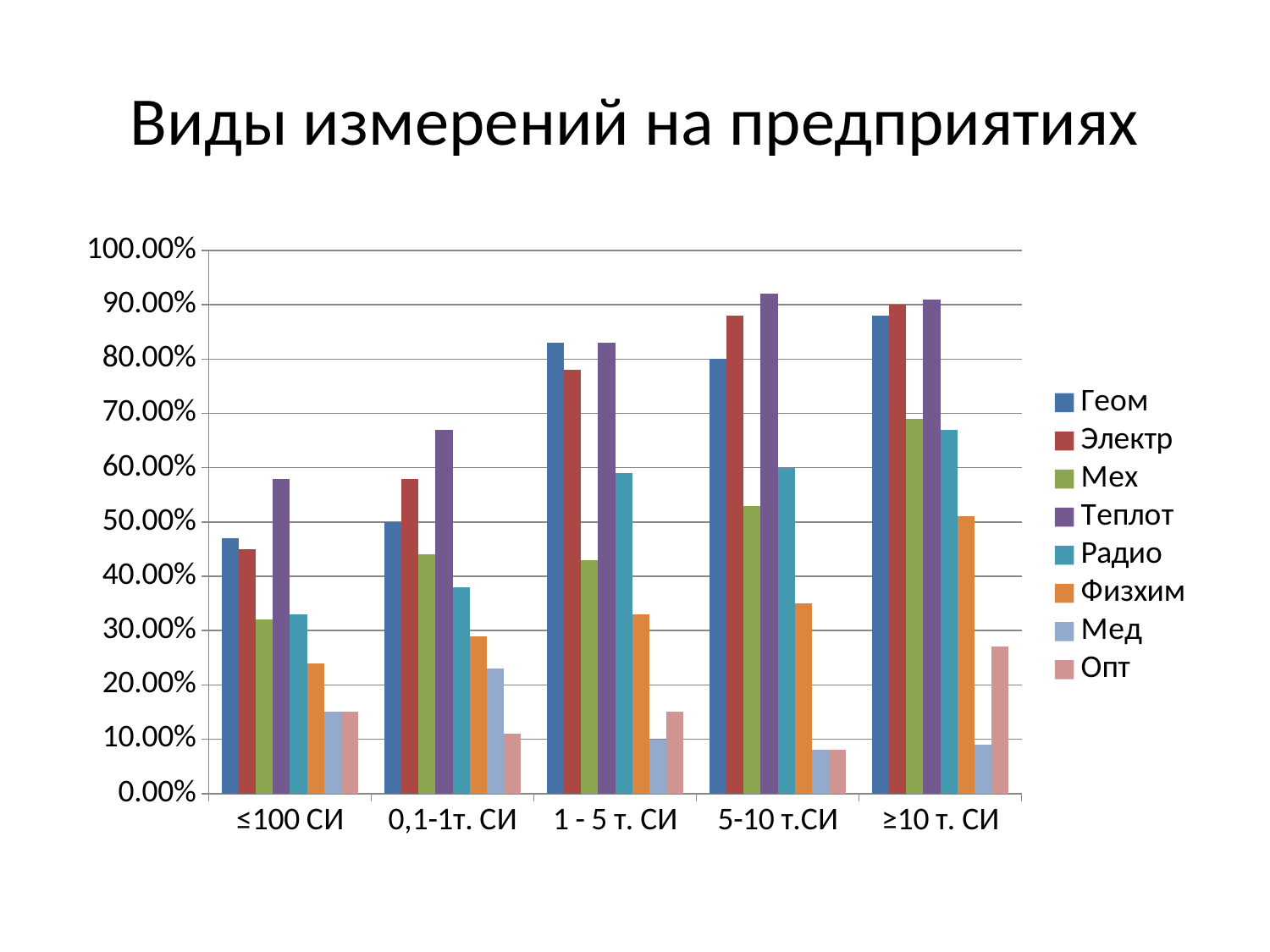
How many categories are shown on the x axis? 5 Is the value for Опт in the ≥10 т. СИ category greater or less than 20.00%? greater How many series does the legend list? 8 In which category does Мех reach its highest value? ≥10 т. СИ In the 0,1-1т. СИ category, which is larger: Теплот or Геом? Теплот Is the value for Мех in the ≥10 т. СИ category greater or less than 60.00%? greater Is the value for Радио in the 1 - 5 т. СИ category greater or less than 50.00%? greater Do the values for Физхим rise or fall from ≤100 СИ to ≥10 т. СИ? Rise What kind of chart is shown on the slide? Bar chart Which series has the highest value in the 5-10 т.СИ category? Теплот Which series has the lowest value in the 0,1-1т. СИ category? Опт What is the title of the chart? Виды измерений на предприятиях